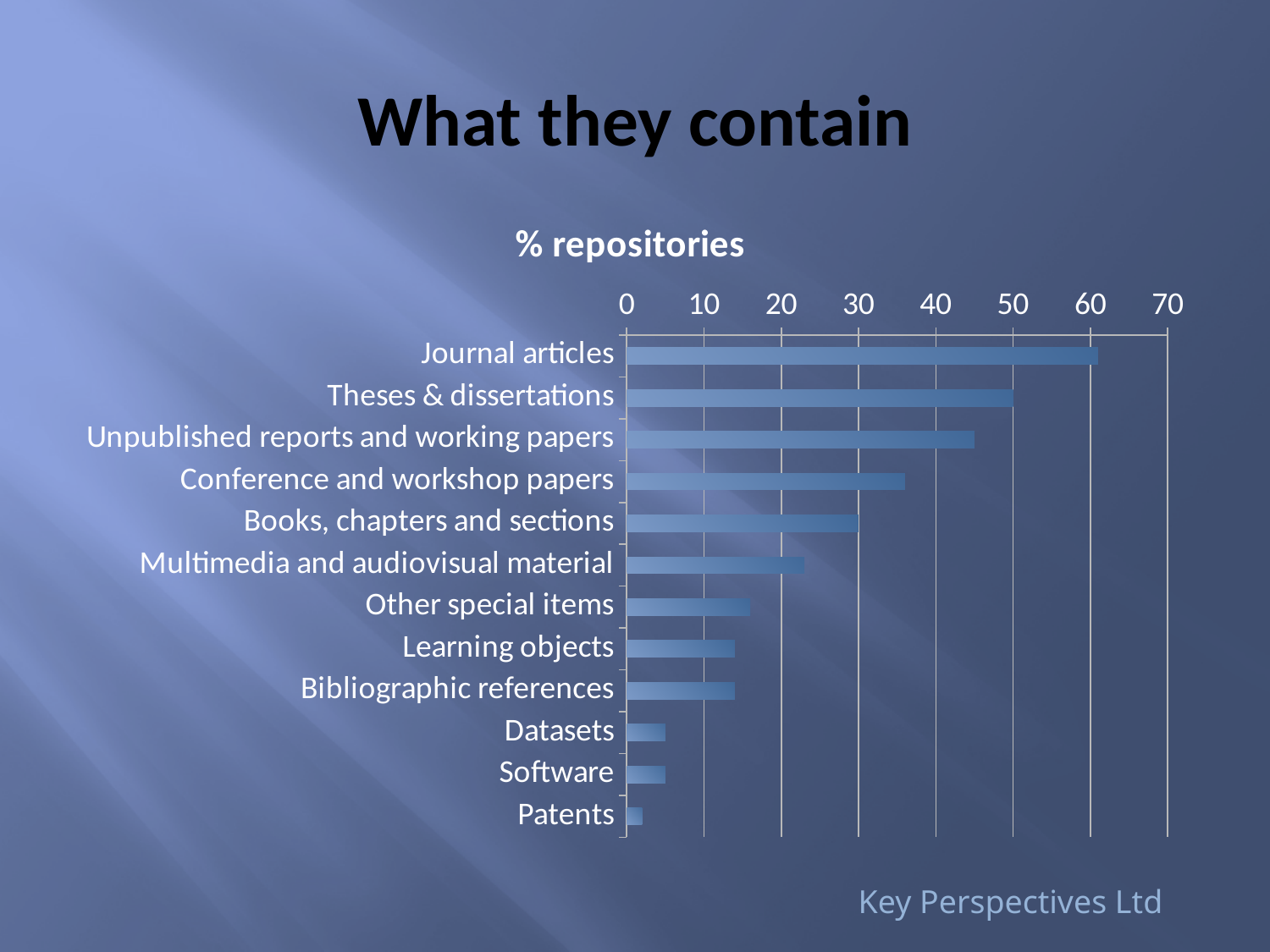
Is the value for Conference and workshop papers greater or less than 40? less What is the title of the chart? % repositories How many categories are plotted in the chart? 12 Which has a larger value, Other special items or Patents? Other special items Is the value for Datasets greater or less than 10? less Is the value for Unpublished reports and working papers greater or less than 40? greater What kind of chart is shown on the slide? bar chart Which category has the lowest value? Patents Which category has the highest value? Journal articles Which has a larger value, Theses & dissertations or Conference and workshop papers? Theses & dissertations